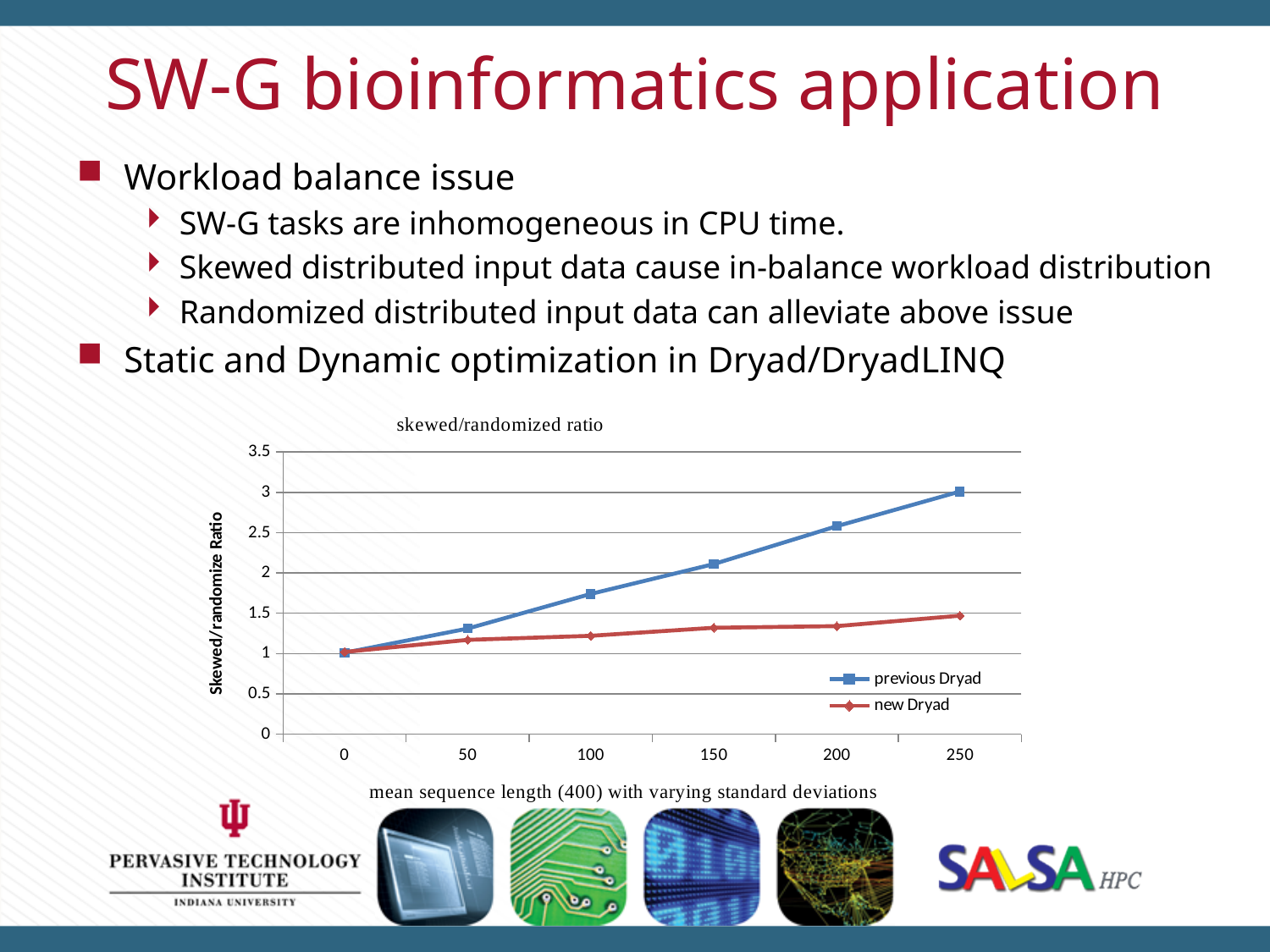
At which x-axis value does the previous Dryad series reach its highest point? 250 Does the previous Dryad series rise or fall as the x-axis value increases from 0 to 250? rise How many series does the chart legend list? 2 Is the value for new Dryad at x = 250 greater or less than 2? less At x = 200, which series has the larger value, previous Dryad or new Dryad? previous Dryad What is the title of the chart? skewed/randomized ratio Which series is drawn in blue with square markers? previous Dryad Is the value for previous Dryad at x = 150 greater or less than 2? greater How many data points are plotted for the previous Dryad series? 6 Is the value for previous Dryad at x = 250 greater or less than 2.5? greater What are the two series named in the chart legend? previous Dryad and new Dryad What kind of chart is shown on the slide? line chart